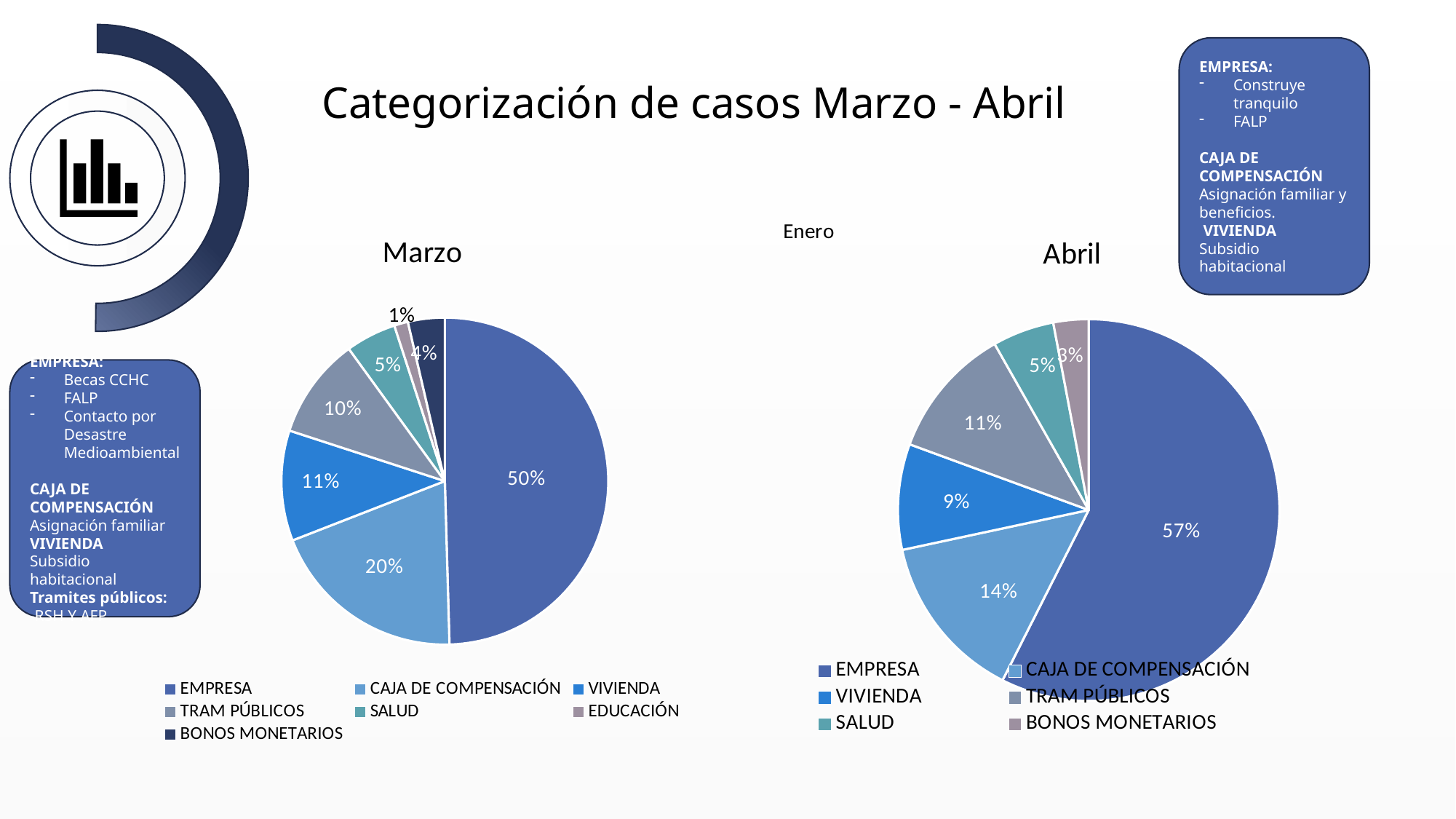
In the Abril chart, what percentage is shown for BONOS MONETARIOS? 3% What is the difference between the EMPRESA share in Abril and the EMPRESA share in Marzo? 7% How many categories does the legend of the Abril chart list? 6 In the Abril chart, what percentage is shown for VIVIENDA? 9% In the Marzo chart, which category has the smallest slice? EDUCACIÓN In the Abril chart, which category has the largest slice? EMPRESA How many categories does the legend of the Marzo chart list? 7 In the Marzo chart, what share of cases is EMPRESA? 50% In the Marzo chart, what percentage is shown for CAJA DE COMPENSACIÓN? 20% In the Abril chart, what share of cases is EMPRESA? 57% In the Marzo chart, which is larger: VIVIENDA or TRAM PÚBLICOS? VIVIENDA What type of chart is used for Marzo and Abril? Pie chart